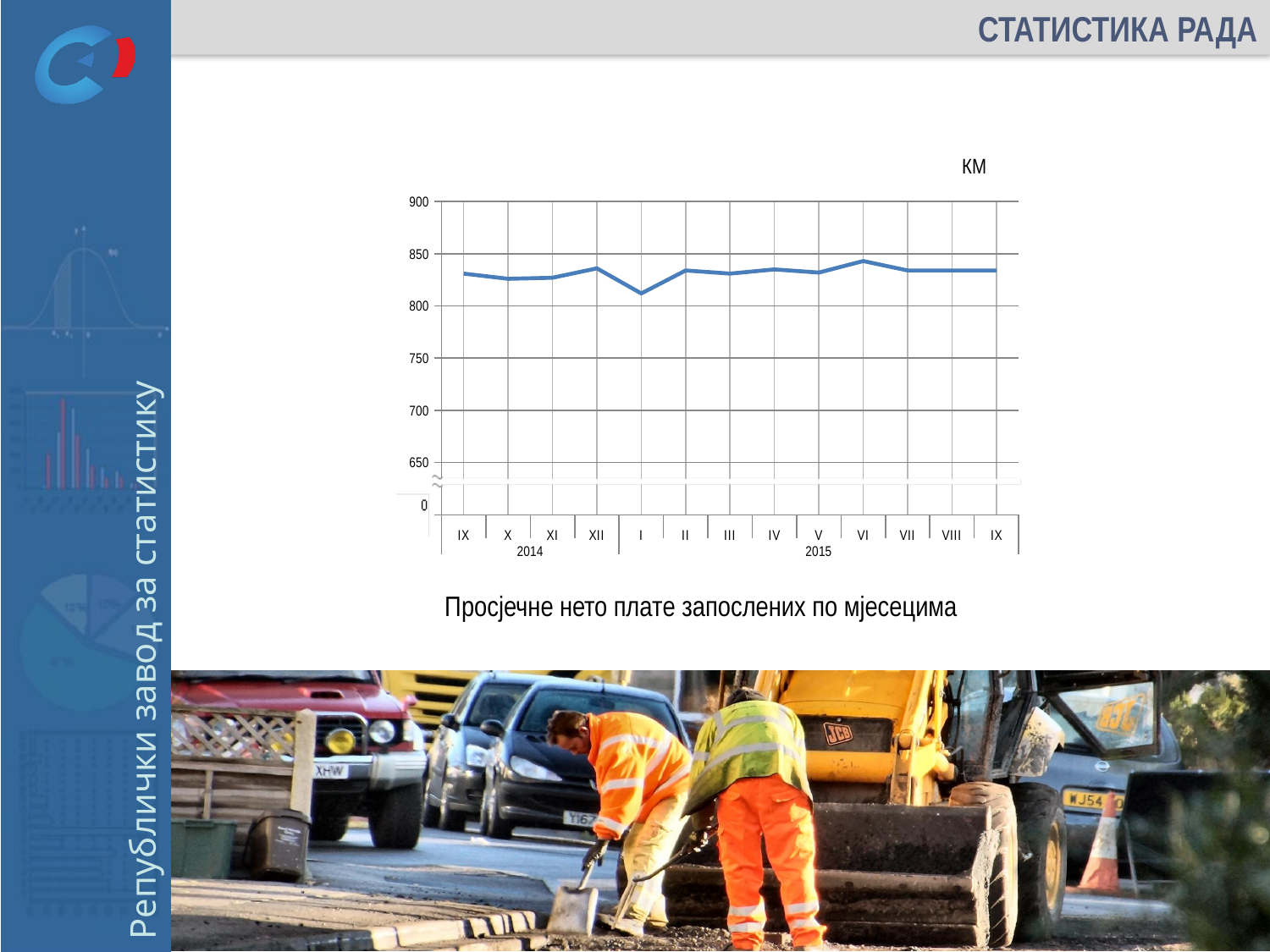
How many monthly data points are plotted on the chart? 13 What unit is indicated above the chart's y axis? КМ Is the value for XII 2014 greater or less than 850? less What is the title of the chart on the slide? Просјечне нето плате запослених по мјесецима Is the value for IX 2014 greater or less than 800? greater Which is larger, the value for I 2015 or the value for VI 2015? VI 2015 Which month has the lowest value on the chart? I 2015 Does the value rise or fall from I 2015 to II 2015? rise What kind of chart is shown on the slide? line chart Does the value rise or fall from XII 2014 to I 2015? fall Which month has the highest value on the chart? VI 2015 Is the value for I 2015 greater or less than 850? less